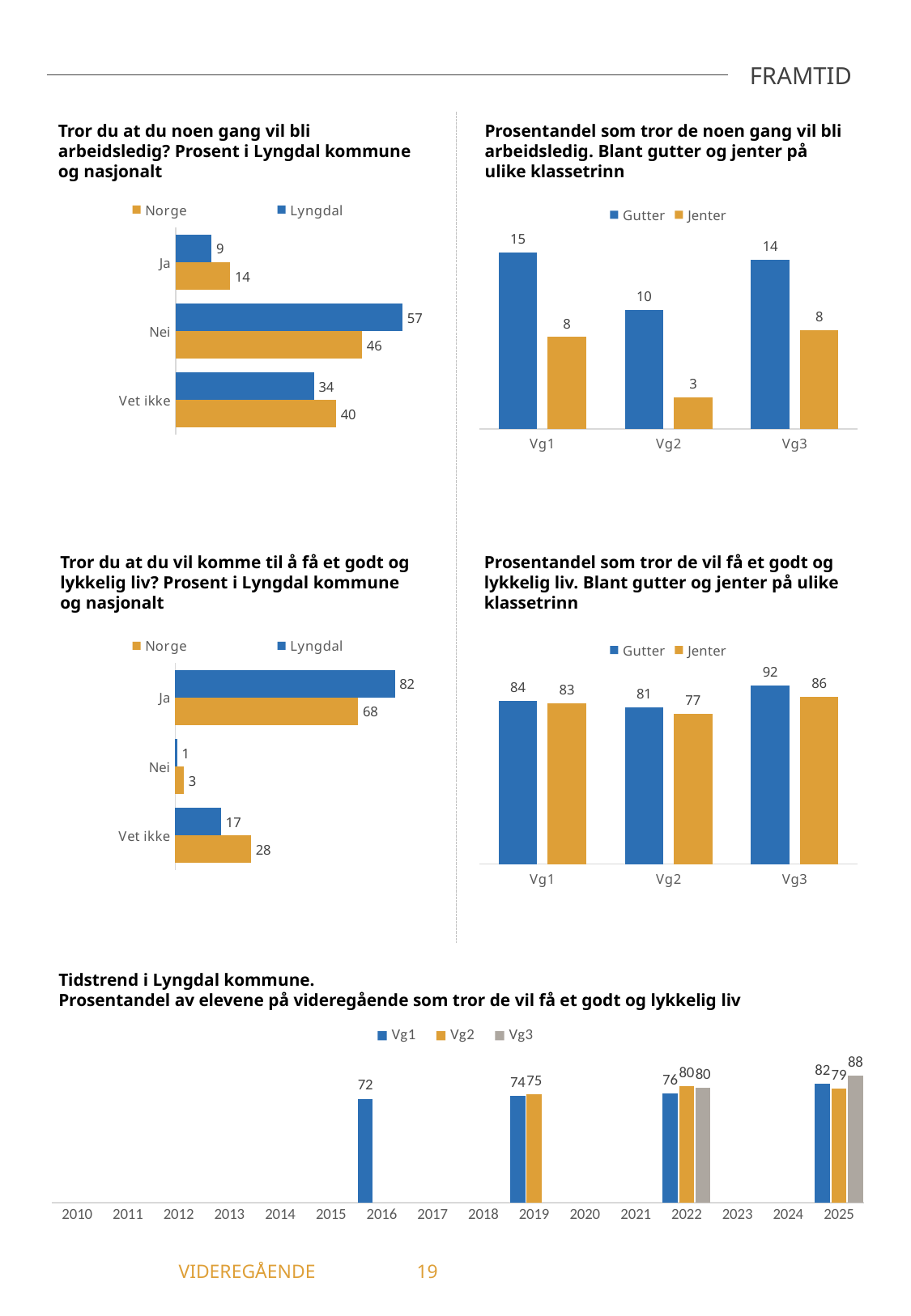
In the top-left chart 'Tror du at du noen gang vil bli arbeidsledig?', what is the value for Lyngdal for 'Nei'? 57 In the bottom chart 'Tidstrend i Lyngdal kommune', what is the value for Vg3 in 2025? 88 In the top-right chart 'Prosentandel som tror de noen gang vil bli arbeidsledig', which class level has the lowest value for Jenter? Vg2 In the middle-left chart 'Tror du at du vil komme til å få et godt og lykkelig liv?', what is the value for Norge for 'Ja'? 68 What kind of chart is the top-left chart 'Tror du at du noen gang vil bli arbeidsledig?'? bar chart In the top-right chart 'Prosentandel som tror de noen gang vil bli arbeidsledig', what is the value for Gutter in Vg1? 15 In the middle-left chart 'Tror du at du vil komme til å få et godt og lykkelig liv?', which is larger for 'Vet ikke': Norge or Lyngdal? Norge How many series does the legend of the bottom chart 'Tidstrend i Lyngdal kommune' list? 3 In the top-left chart 'Tror du at du noen gang vil bli arbeidsledig?', what is the difference between the Norge and Lyngdal values for 'Vet ikke'? 6 In the middle-right chart 'Prosentandel som tror de vil få et godt og lykkelig liv', which class level has the highest value for Gutter? Vg3 In the bottom chart 'Tidstrend i Lyngdal kommune', does the Vg1 value rise or fall from 2016 to 2025? rise In the middle-right chart 'Prosentandel som tror de vil få et godt og lykkelig liv', what is the difference between Gutter and Jenter in Vg2? 4